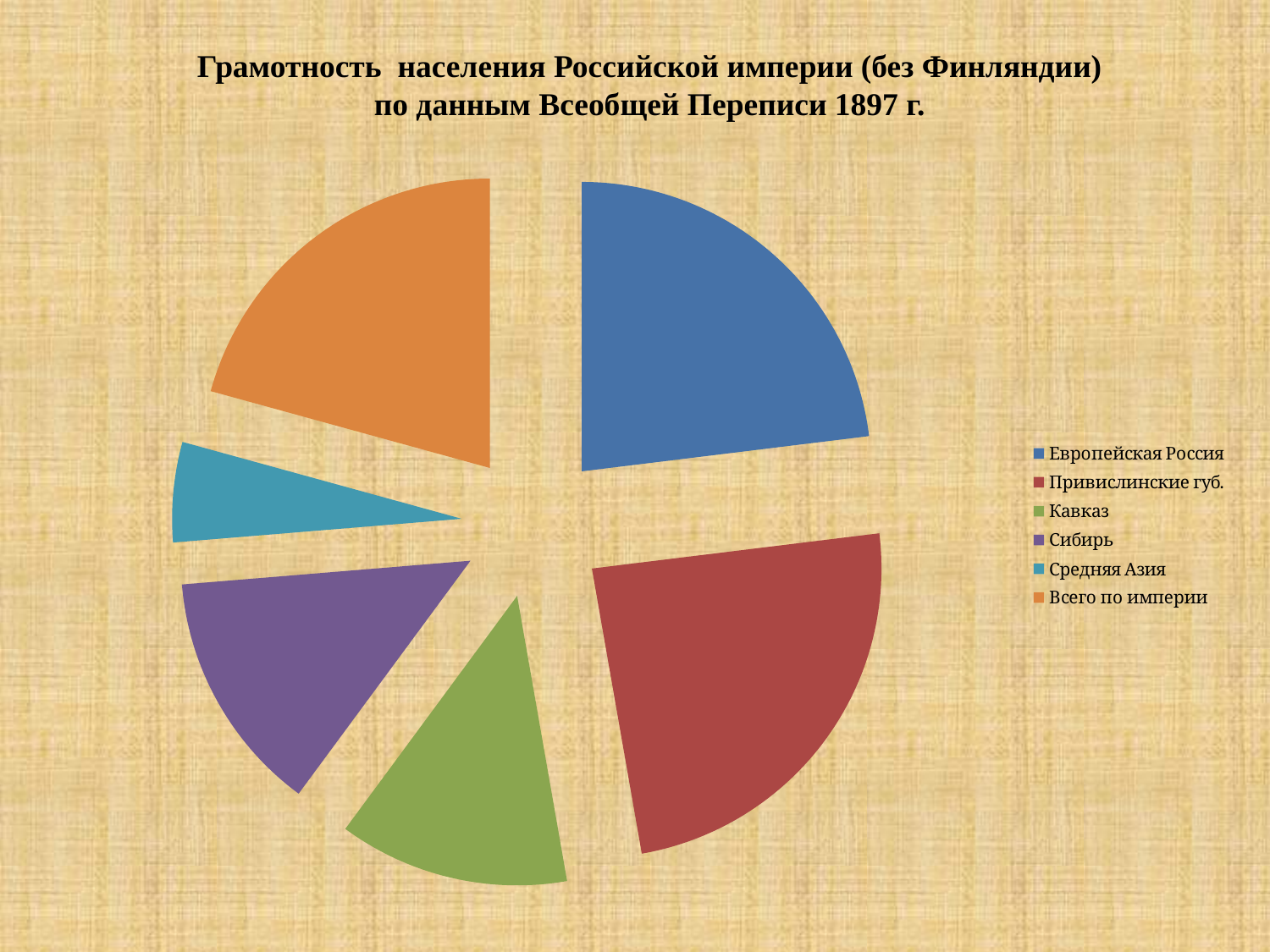
How many entries does the legend list? 6 Which slice is larger, Сибирь or Средняя Азия? Сибирь Which category has the smallest slice of the pie? Средняя Азия What is the title of the chart? Грамотность населения Российской империи (без Финляндии) по данным Всеобщей Переписи 1897 г. What colour is the slice for Кавказ? green Which slice is larger, Привислинские губ. or Сибирь? Привислинские губ. Which category has the largest slice of the pie? Привислинские губ. How many slices does the pie chart have? 6 Which slice is larger, Всего по империи or Кавказ? Всего по империи What kind of chart is shown on the slide? pie chart